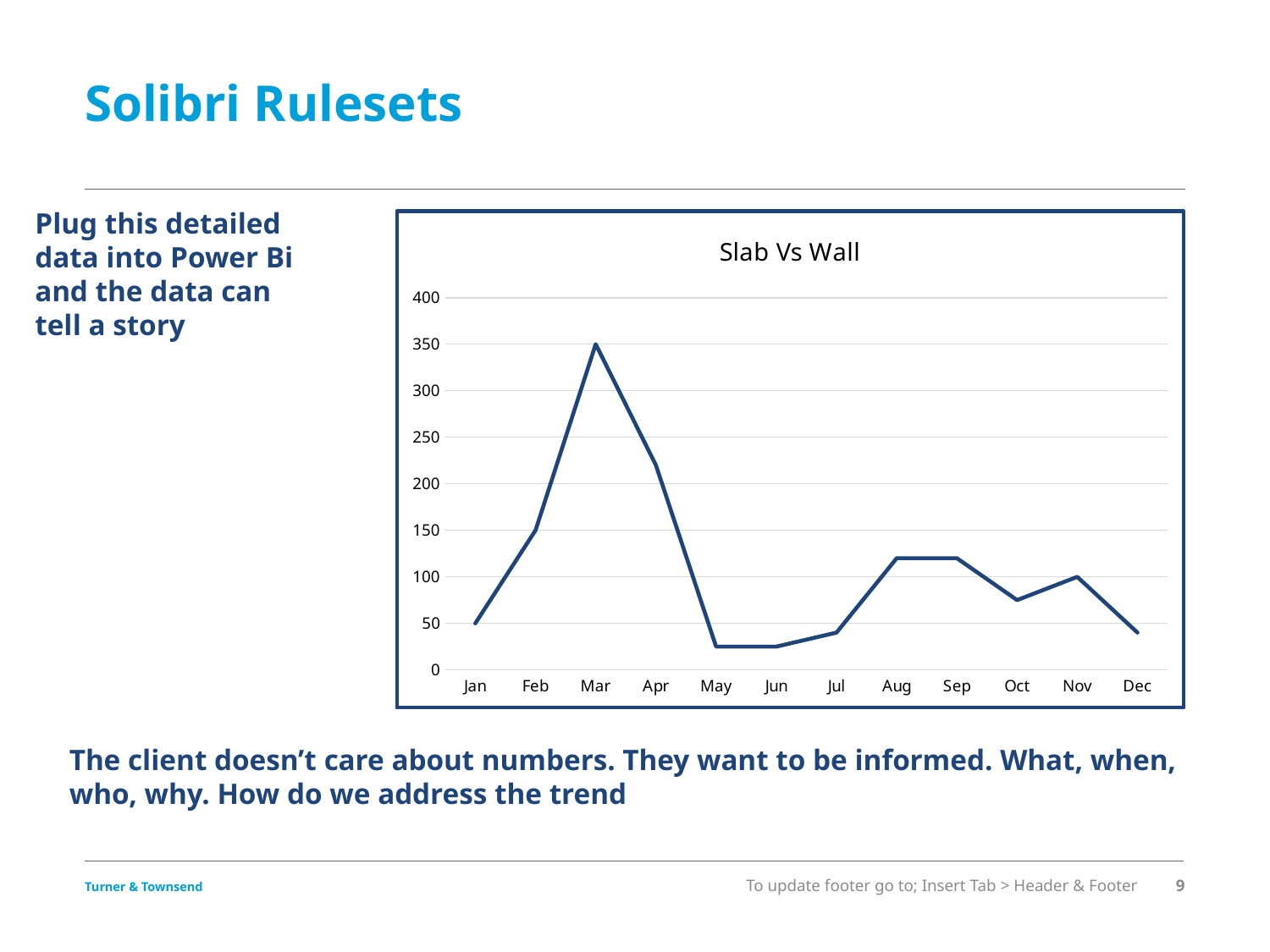
What is the value for Mar? 350 Which month has the highest value? Mar Is the value for Apr greater or less than 200? greater Do the values rise or fall from Jan to Mar? rise How many months are plotted along the x axis? 12 What kind of chart is shown on the slide? line chart What is the value for Jan? 50 What is the title of the chart? Slab Vs Wall Is the value for May greater or less than 50? less What is the highest value shown on the y axis? 400 Which is larger, the value for Aug or the value for Dec? Aug Is the value for Oct greater or less than 100? less